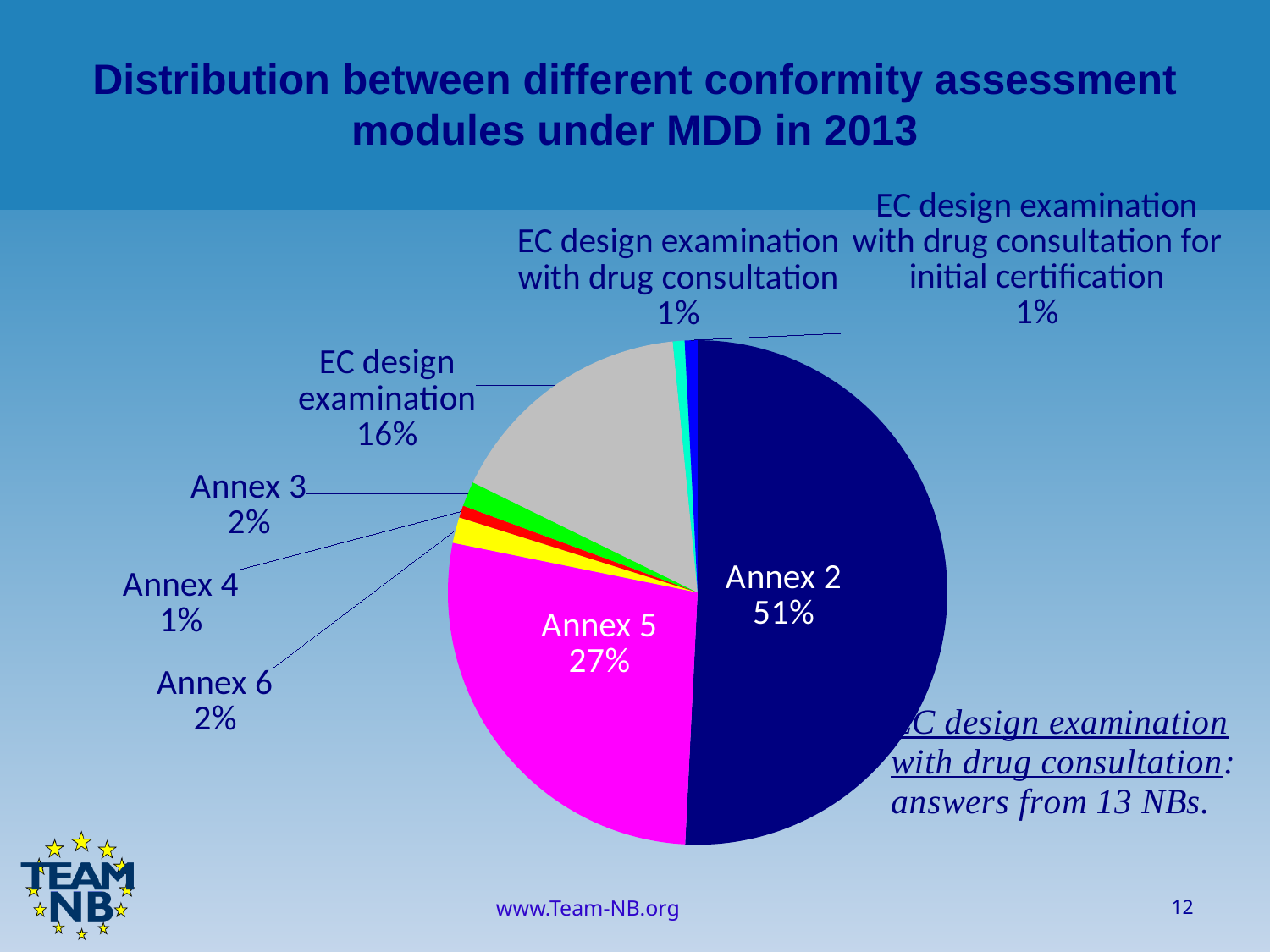
What percentage is shown for Annex 4? 1% What percentage is shown for Annex 3? 2% What percentage is shown for EC design examination with drug consultation for initial certification? 1% What share of the pie does Annex 5 represent? 27% Which category has the largest slice of the pie? Annex 2 What percentage is shown for EC design examination? 16% What share of the pie does Annex 2 represent? 51% What is the title of the chart on the slide? Distribution between different conformity assessment modules under MDD in 2013 Which is larger, the share for EC design examination or the share for Annex 5? Annex 5 What is the difference in percentage points between Annex 2 and Annex 5? 24 How many slices does the pie chart have? 8 What type of chart is shown on the slide? pie chart